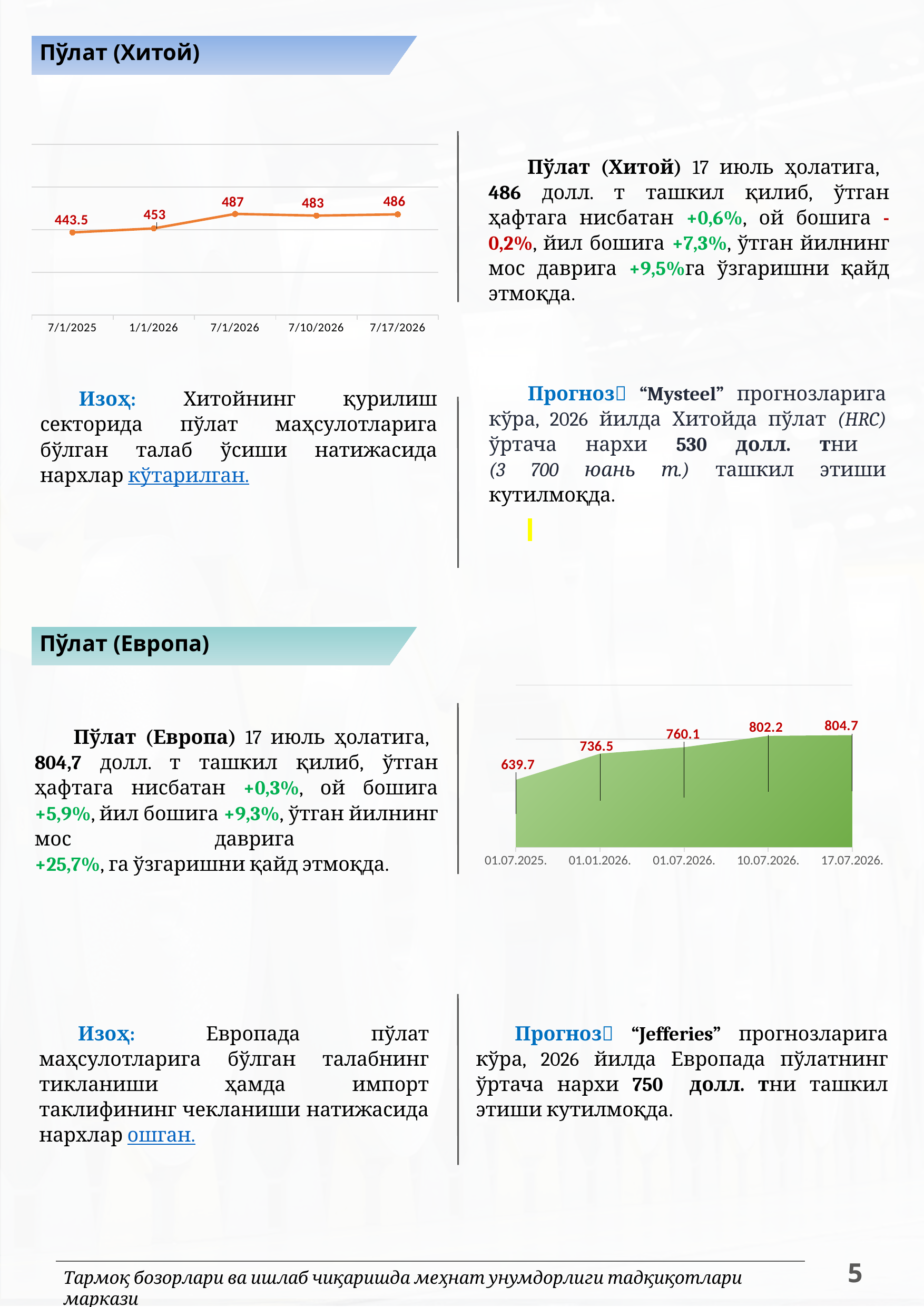
In the bottom chart (Пўлат (Европа)), do the values rise or fall from 01.07.2025. to 17.07.2026.? Rise In the bottom chart (Пўлат (Европа)), what is the difference between the values for 17.07.2026. and 01.07.2025.? 165 In the top chart (Пўлат (Хитой)), which date has the lowest value? 7/1/2025 In the bottom chart (Пўлат (Европа)), what is the value for 17.07.2026.? 804.7 In the top chart (Пўлат (Хитой)), which date has the highest value? 7/1/2026 What type of chart is the top chart (Пўлат (Хитой))? Line chart In the top chart (Пўлат (Хитой)), what is the difference between the values for 7/1/2026 and 7/10/2026? 4 In the top chart (Пўлат (Хитой)), what is the value for 7/17/2026? 486 In the bottom chart (Пўлат (Европа)), which date has the lowest value? 01.07.2025. In the top chart (Пўлат (Хитой)), how many data points are plotted? 5 In the top chart (Пўлат (Хитой)), what is the value for 7/1/2025? 443.5 In the bottom chart (Пўлат (Европа)), what is the value for 01.01.2026.? 736.5